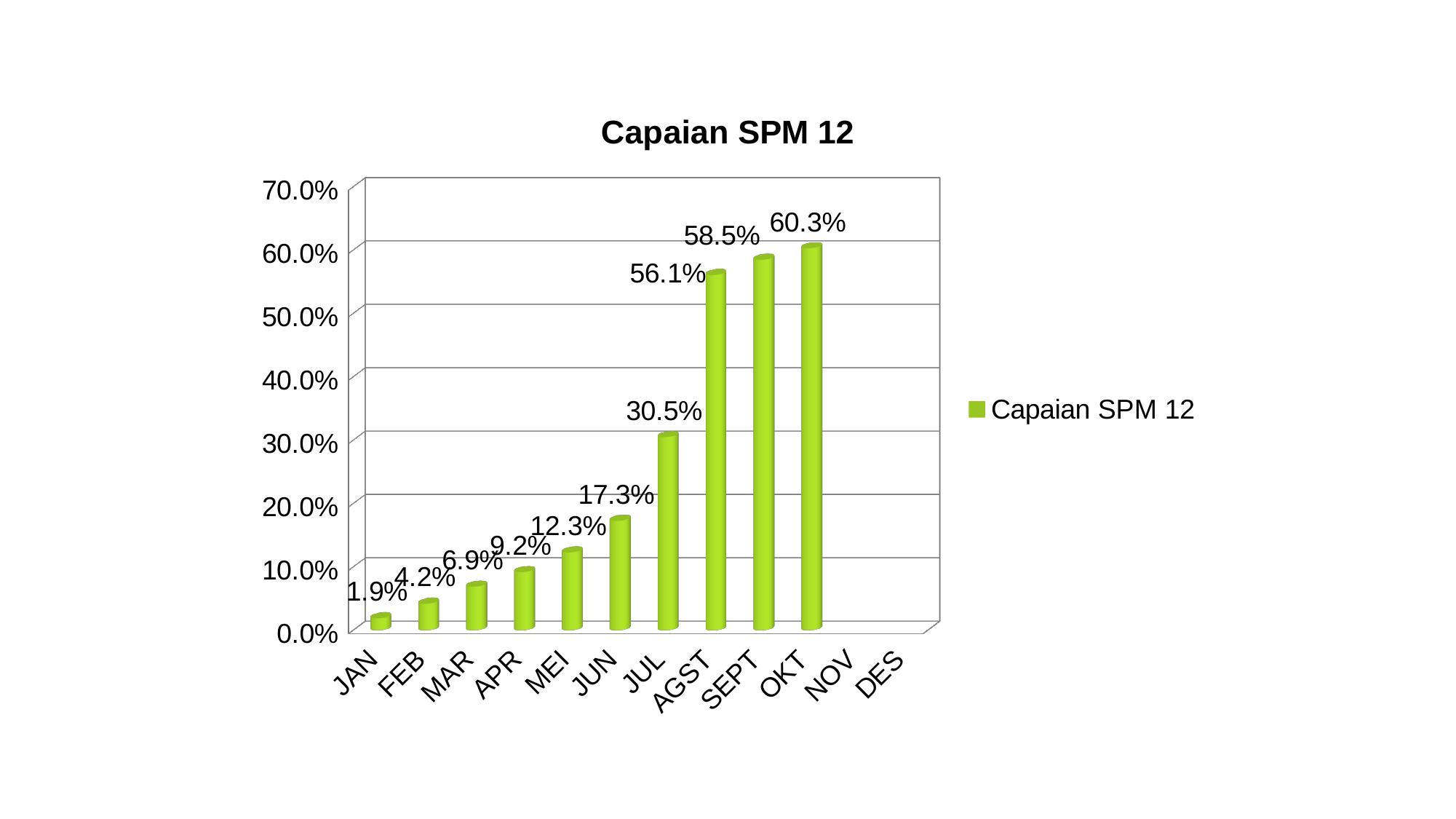
Which month has the lowest plotted value? JAN How many months are labelled on the x axis? 12 Which is larger, the value for JUN or the value for MEI? JUN What is the value for SEPT? 58.5% What kind of chart is shown? bar chart Is the value for AGST greater or less than 50.0%? greater How many series does the legend list? 1 Do the values rise or fall from JAN to OKT? rise What is the value for MAR? 6.9% Which month has the highest value? OKT What is the value for JUL? 30.5% What is the difference between the values for OKT and AGST? 4.2%